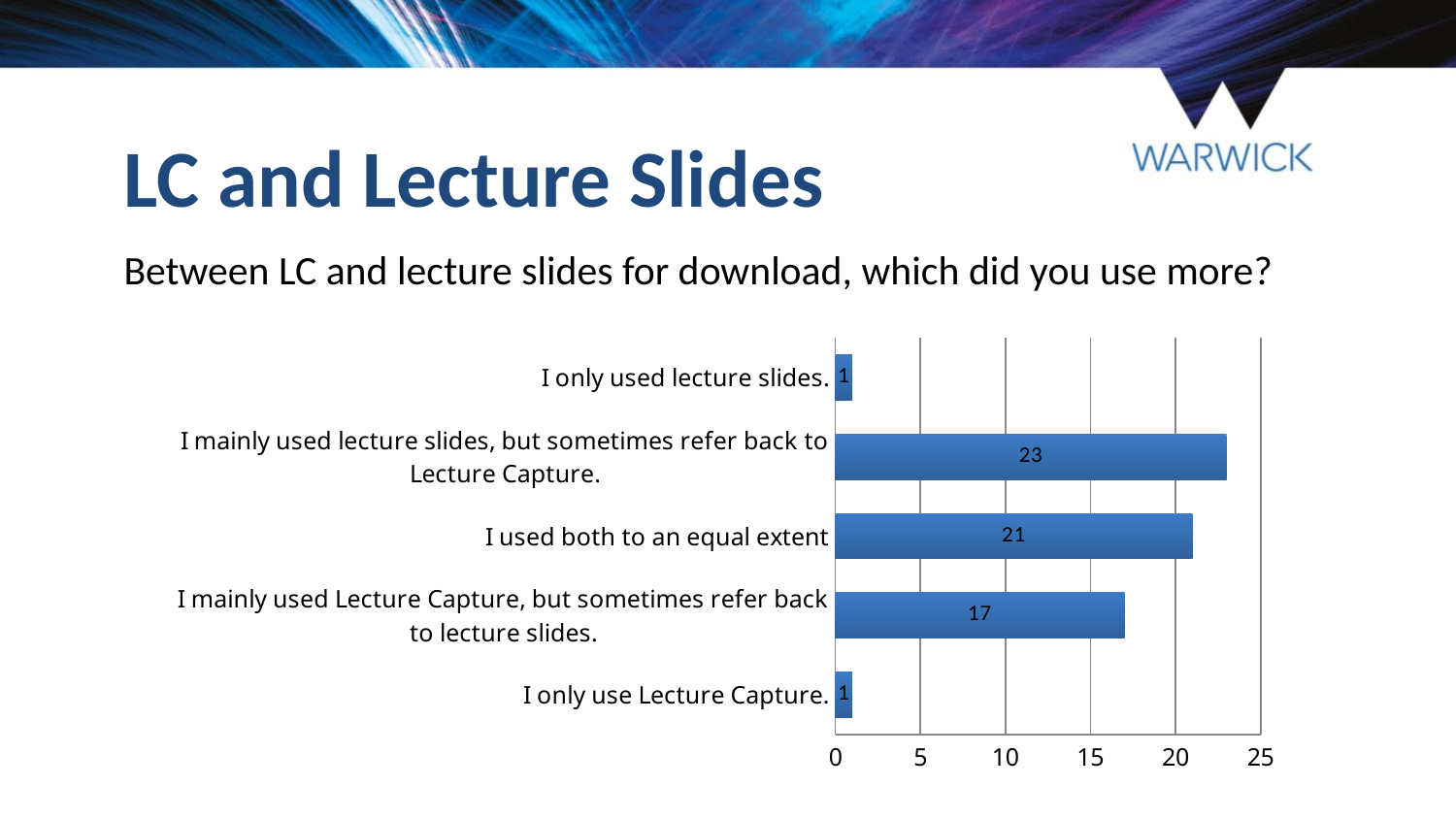
What is the total of the values for "I only used lecture slides." and "I only use Lecture Capture."? 2 What is the value for "I mainly used Lecture Capture, but sometimes refer back to lecture slides."? 17 Which is larger: the value for "I used both to an equal extent" or the value for "I mainly used Lecture Capture, but sometimes refer back to lecture slides."? I used both to an equal extent What kind of chart is shown on the slide? bar chart What is the value for "I used both to an equal extent"? 21 What is the value for "I mainly used lecture slides, but sometimes refer back to Lecture Capture."? 23 How many categories are shown in the chart? 5 Which category has the highest value? I mainly used lecture slides, but sometimes refer back to Lecture Capture. What is the value for "I only used lecture slides."? 1 What is the maximum value shown on the horizontal axis? 25 What is the difference between the values for "I mainly used lecture slides, but sometimes refer back to Lecture Capture." and "I mainly used Lecture Capture, but sometimes refer back to lecture slides."? 6 Is the value for "I used both to an equal extent" greater or less than 20? greater